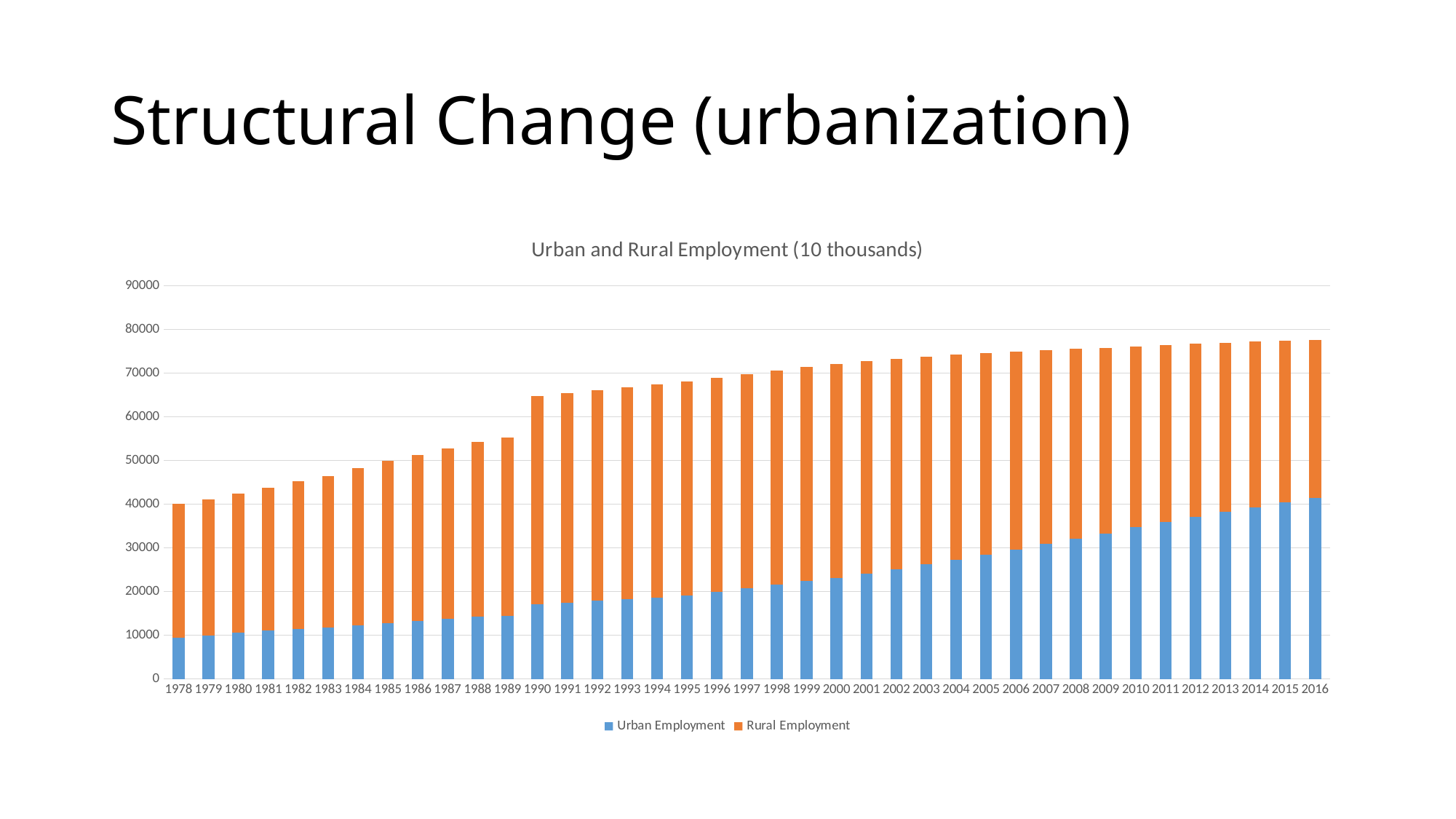
Which colour represents Urban Employment in the chart? blue Which year has the highest total employment (urban plus rural)? 2016 What kind of chart is shown on the slide? stacked bar chart Which is larger, Urban Employment in 2010 or Urban Employment in 1990? 2010 Is the Urban Employment value for 2016 greater or less than 40000? greater How many series does the legend list? 2 How many years are plotted along the x axis? 39 Which year has the lowest total employment (urban plus rural)? 1978 Does Urban Employment rise or fall from 1978 to 2016? rise What is the title of the chart? Urban and Rural Employment (10 thousands) Is the total stacked bar for 1990 greater or less than 60000? greater Is the total stacked bar for 2016 greater or less than 80000? less